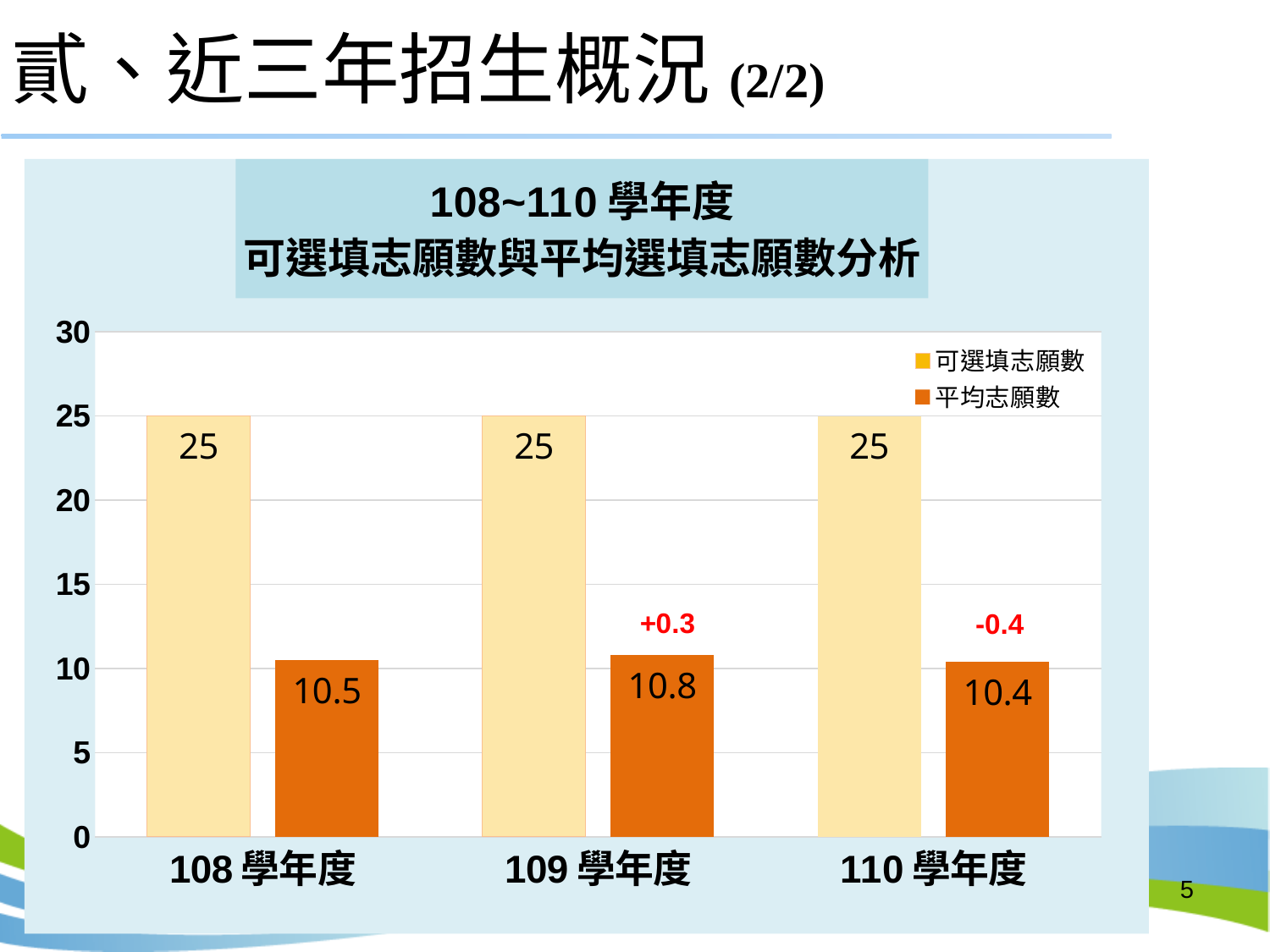
Which 學年度 has the lowest 平均志願數? 110 學年度 What is the value of 平均志願數 for 108 學年度? 10.5 How many series does the legend list? 2 How many 學年度 categories are shown on the x axis? 3 What kind of chart is shown on the slide? Bar chart What is the difference in 平均志願數 between 109 學年度 and 110 學年度? 0.4 Is the 平均志願數 for 109 學年度 larger than that for 108 學年度? Yes What is the value of 平均志願數 for 109 學年度? 10.8 Which 學年度 has the highest 平均志願數? 109 學年度 What is the value of 可選填志願數 for 110 學年度? 25 What is the change in 平均志願數 annotated above the 110 學年度 bar? -0.4 What is the difference between 可選填志願數 and 平均志願數 for 108 學年度? 14.5